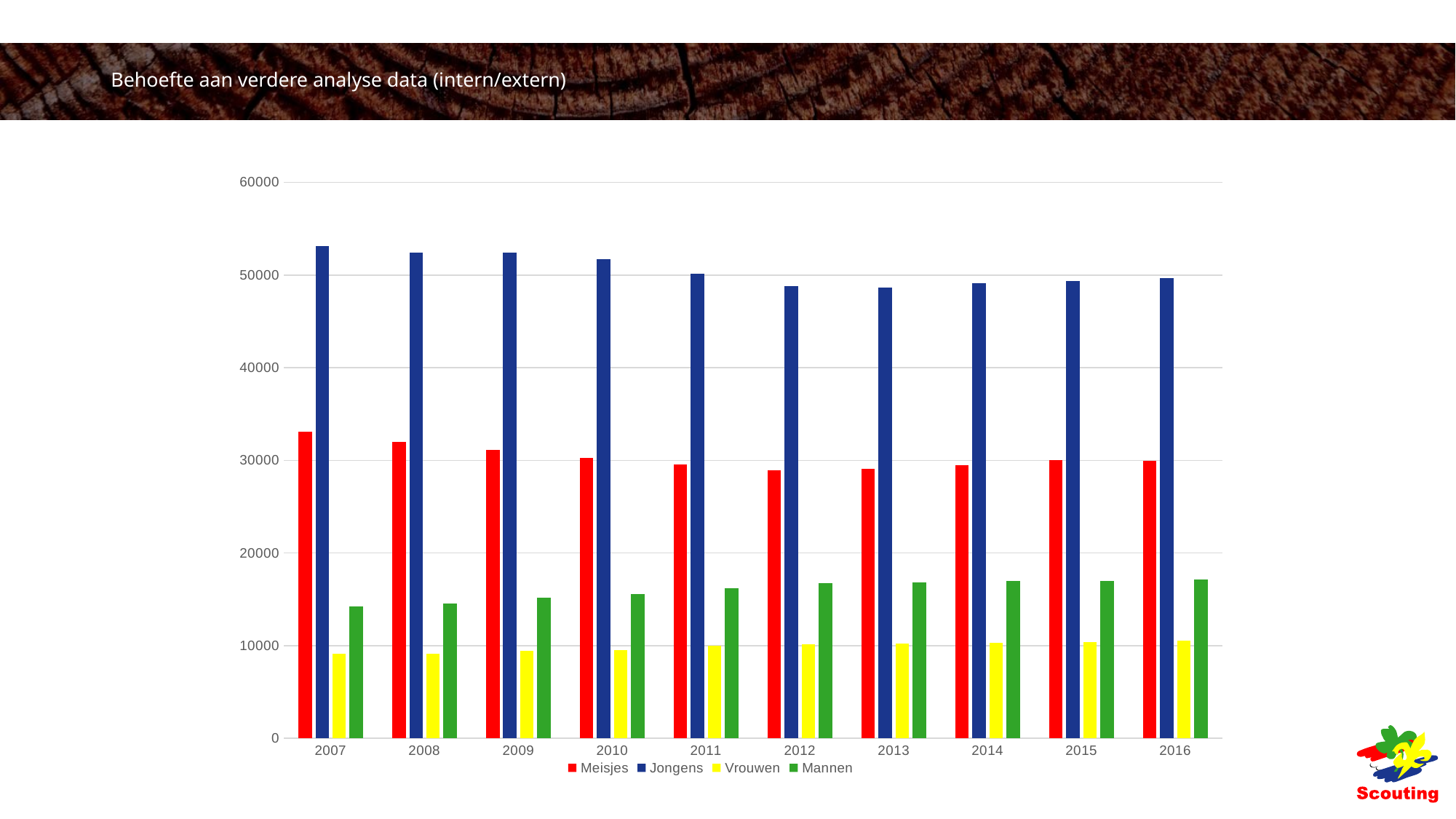
Do the Mannen values generally rise or fall from 2007 to 2016? rise How many years are shown on the x axis? 10 In which year is the Mannen value lowest? 2007 Is the value for Vrouwen in 2007 greater or less than 10000? less Is the value for Mannen in 2007 greater or less than 20000? less Is the value for Meisjes in 2012 greater or less than 30000? less How many series does the legend list? 4 Which series is shown in yellow in the legend? Vrouwen In 2010, which is larger: Jongens or Meisjes? Jongens In which year is the Meisjes value highest? 2007 What kind of chart is shown on the slide? bar chart